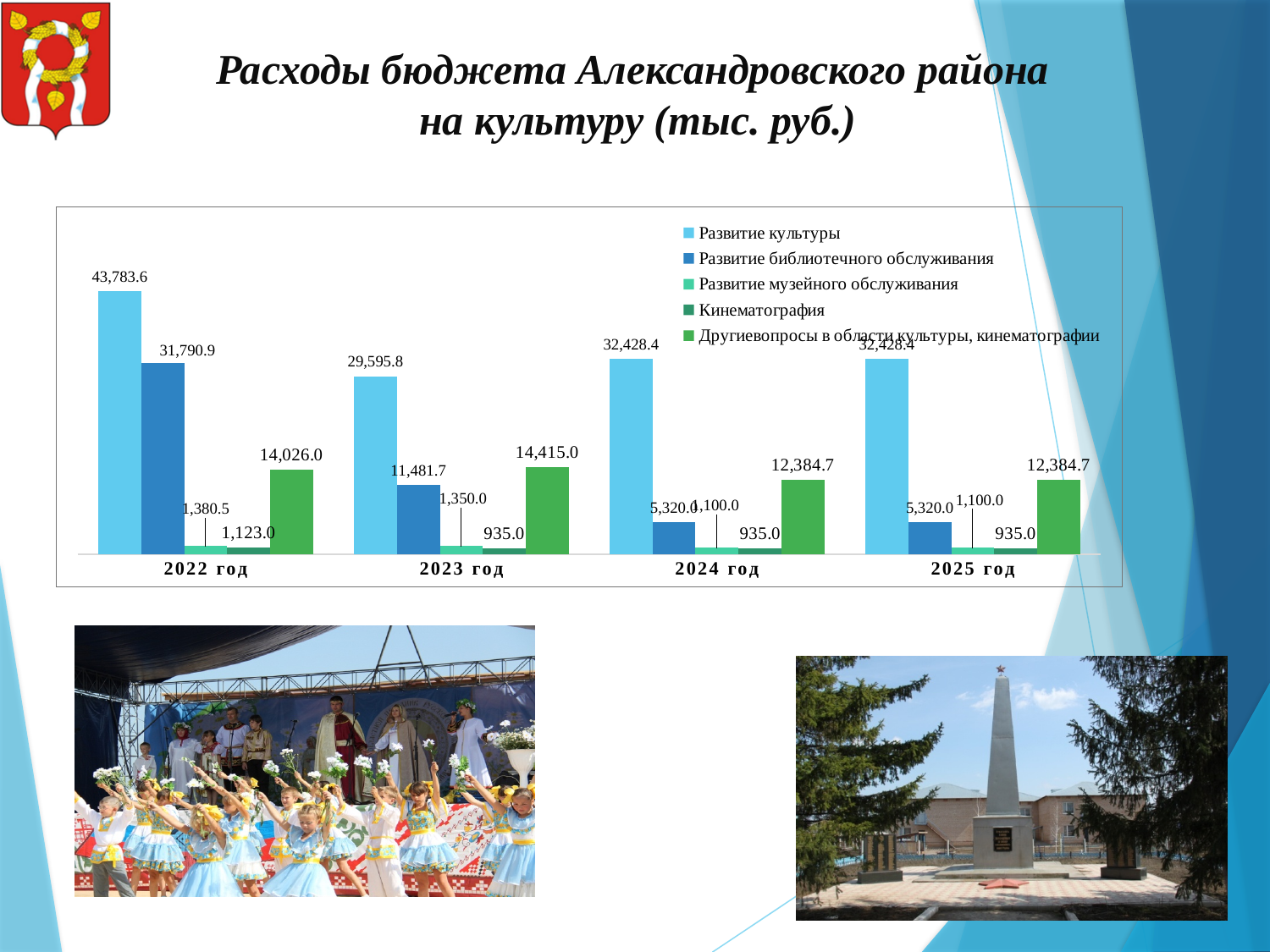
What type of chart is shown on the slide? bar chart How many year categories are shown on the x axis? 4 Which is larger: Другие вопросы в области культуры, кинематографии in 2023 год or in 2022 год? 2023 год What is the difference between Развитие культуры in 2022 год and 2023 год? 14,187.8 What is the value for Другие вопросы в области культуры, кинематографии in 2024 год? 12,384.7 How many series does the legend list? 5 What is the value for Развитие музейного обслуживания in 2022 год? 1,380.5 In which year is the value for Развитие культуры the highest? 2022 год What is the value for Развитие библиотечного обслуживания in 2023 год? 11,481.7 What is the title of the chart on the slide? Расходы бюджета Александровского района на культуру (тыс. руб.) What is the value for Развитие культуры in 2022 год? 43,783.6 In which year is the value for Развитие библиотечного обслуживания the lowest among 2022 and 2023? 2023 год